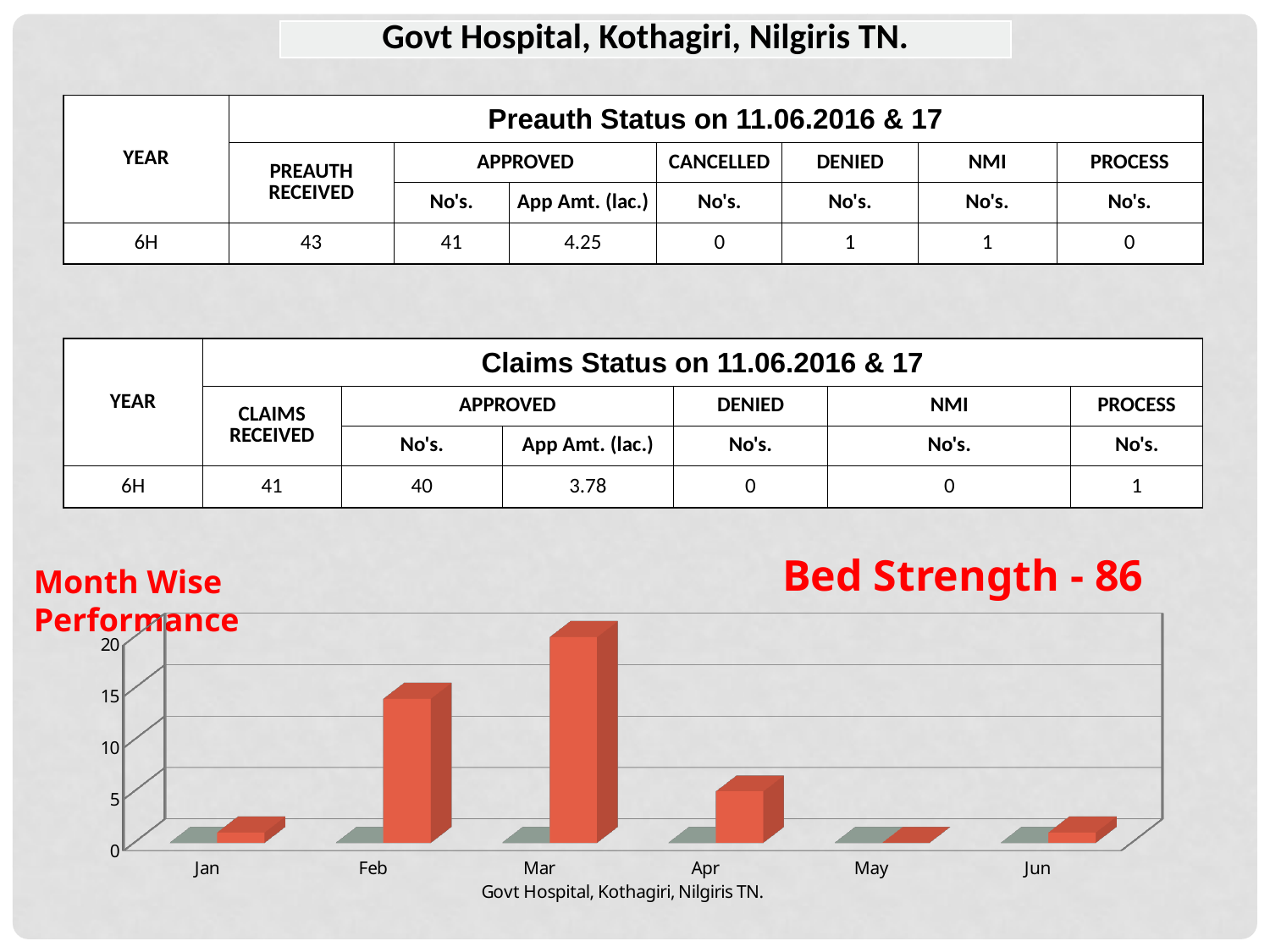
Which month has the lowest bar in the Month Wise Performance chart? May What kind of chart is shown under the heading 'Month Wise Performance'? bar chart In the Month Wise Performance chart, which month has the larger value, Feb or Apr? Feb In the Month Wise Performance chart, is the value for Jan greater or less than 5? less Which month has the highest bar in the Month Wise Performance chart? Mar How many months are plotted on the x axis of the Month Wise Performance chart? 6 In the Month Wise Performance chart, do the values rise or fall from Feb to Mar? rise What text appears as the label beneath the x axis of the Month Wise Performance chart? Govt Hospital, Kothagiri, Nilgiris TN. In the Month Wise Performance chart, is the value for Feb greater or less than 10? greater In the Month Wise Performance chart, do the values rise or fall from Mar to Apr? fall In the Month Wise Performance chart, is the value for Mar greater or less than 15? greater